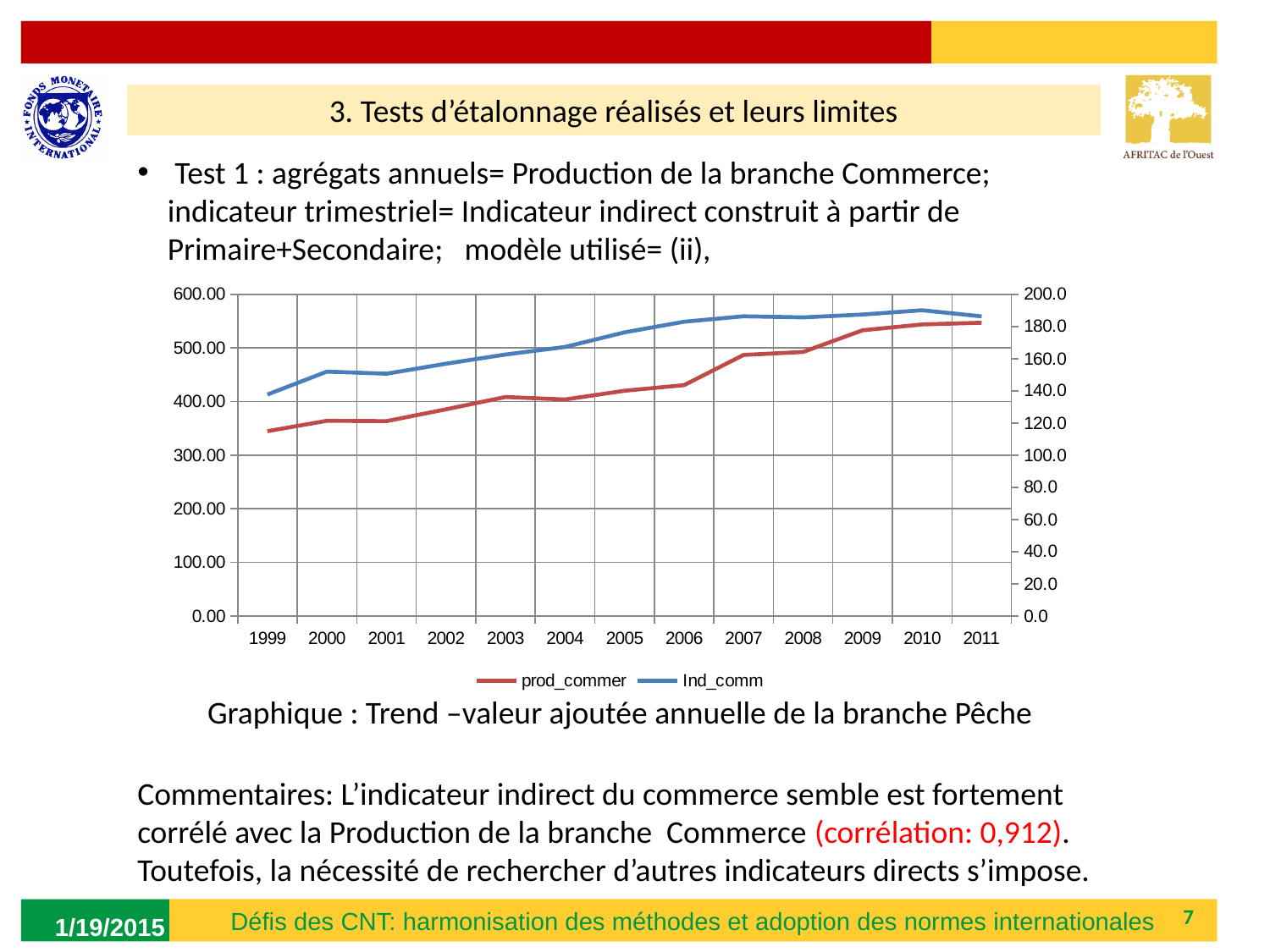
What is the first year shown on the x axis of the chart? 1999 What kind of chart is shown on the slide? line chart Reading against the left-hand axis, is the prod_commer value for 1999 greater or less than 300? greater Does the prod_commer line generally rise or fall from 1999 to 2011? rise How many years are plotted along the x axis of the chart? 13 Which series is plotted higher on the chart in 2005, prod_commer or Ind_comm? Ind_comm In which year does the prod_commer line reach its lowest point? 1999 In which year does the prod_commer line reach its highest point? 2011 How many series does the chart legend list? 2 Does the Ind_comm line generally rise or fall from 1999 to 2011? rise What colour is the prod_commer line in the chart? red In which year does the Ind_comm line reach its highest point? 2010